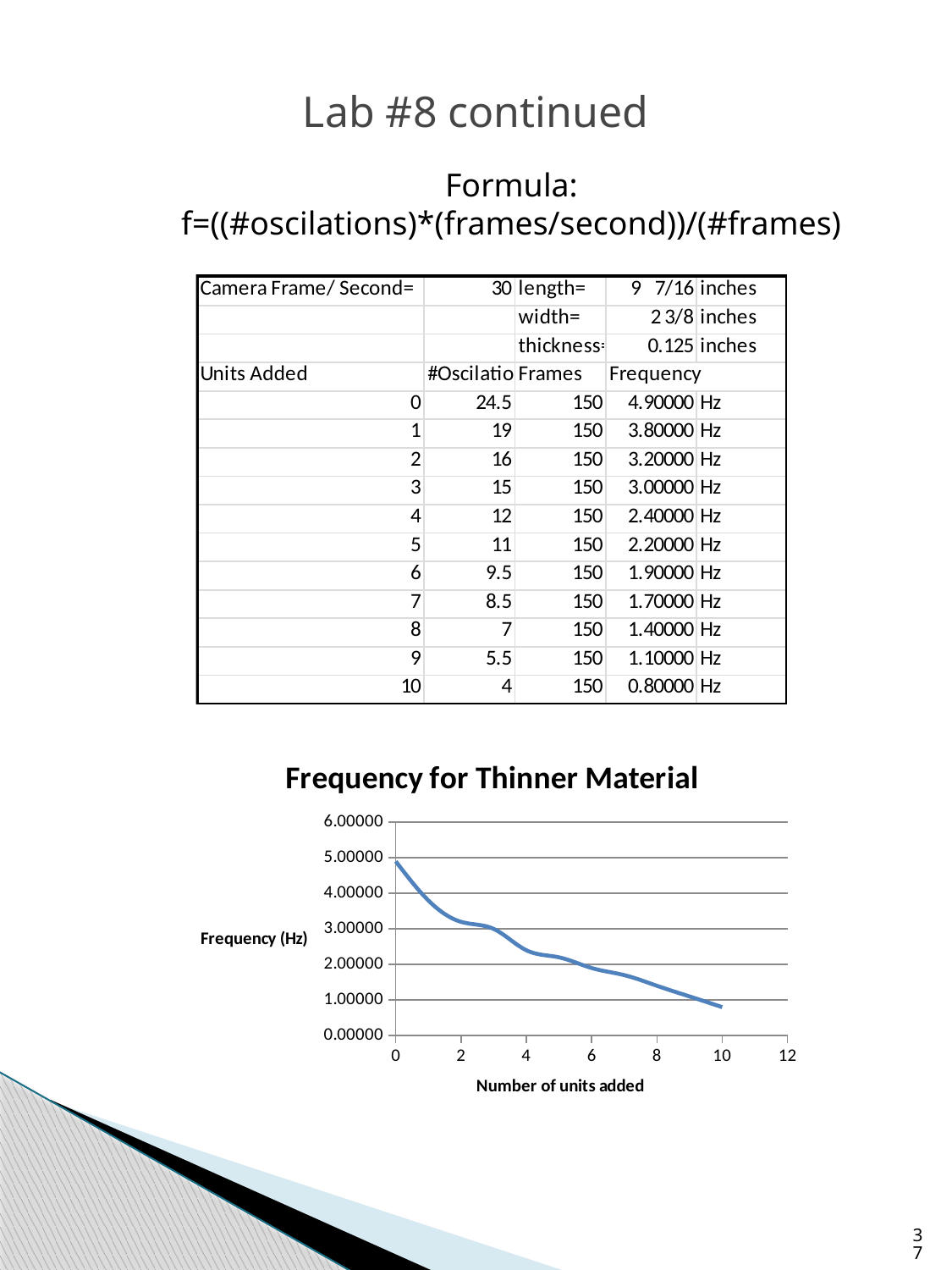
At which number of units added is the frequency lowest? 10 What is the label of the x axis of the chart? Number of units added How many data points are plotted on the chart? 11 What is the title of the chart? Frequency for Thinner Material Which has the higher frequency: 2 units added or 8 units added? 2 units added Is the frequency at 0 units added greater or less than 4.00000? greater Does the frequency rise or fall as the number of units added increases? fall According to the table on the slide, what is the frequency at 5 units added? 2.20000 Hz Is the frequency at 4 units added greater or less than 2.00000? greater Is the frequency at 10 units added greater or less than 1.00000? less What kind of chart is shown on the slide? line chart At which number of units added is the frequency highest? 0